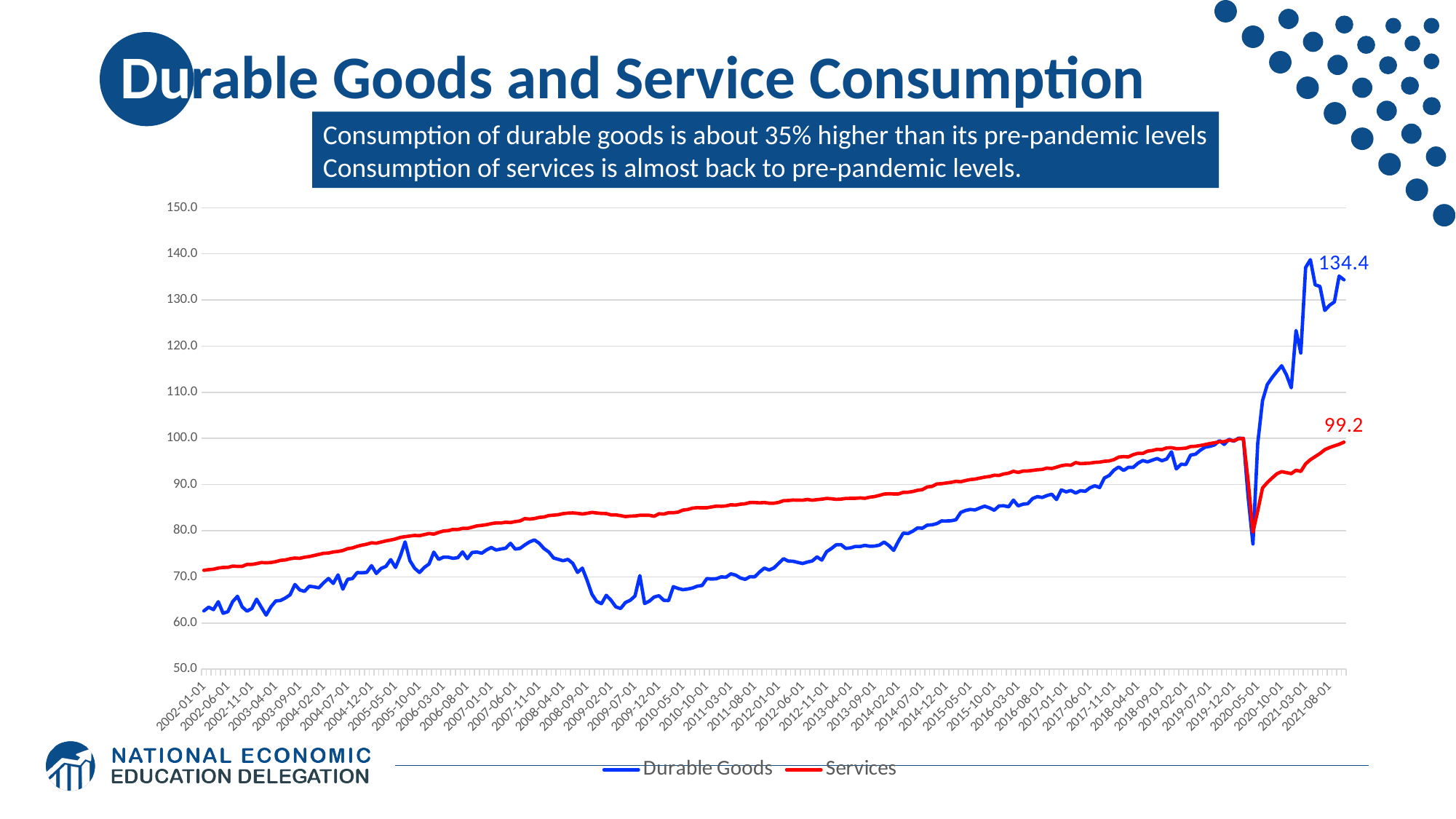
What is the final labelled value of the Durable Goods series? 134.4 What colour is the Services line in the legend? red How many series does the legend list? 2 Is the value for Durable Goods at 2002-01-01 greater or less than 70? less At the end of the series, which is higher: Durable Goods or Services? Durable Goods Is the value for Durable Goods at 2021-03-01 greater or less than 120? greater What is the difference between the final labelled values of Durable Goods (134.4) and Services (99.2)? 35.2 What is the final labelled value of the Services series? 99.2 Does the Services series generally rise or fall from 2002-01-01 to 2019-12-01? rise Is the value for Services at 2002-01-01 greater or less than 80? less What kind of chart is shown on the slide? line chart